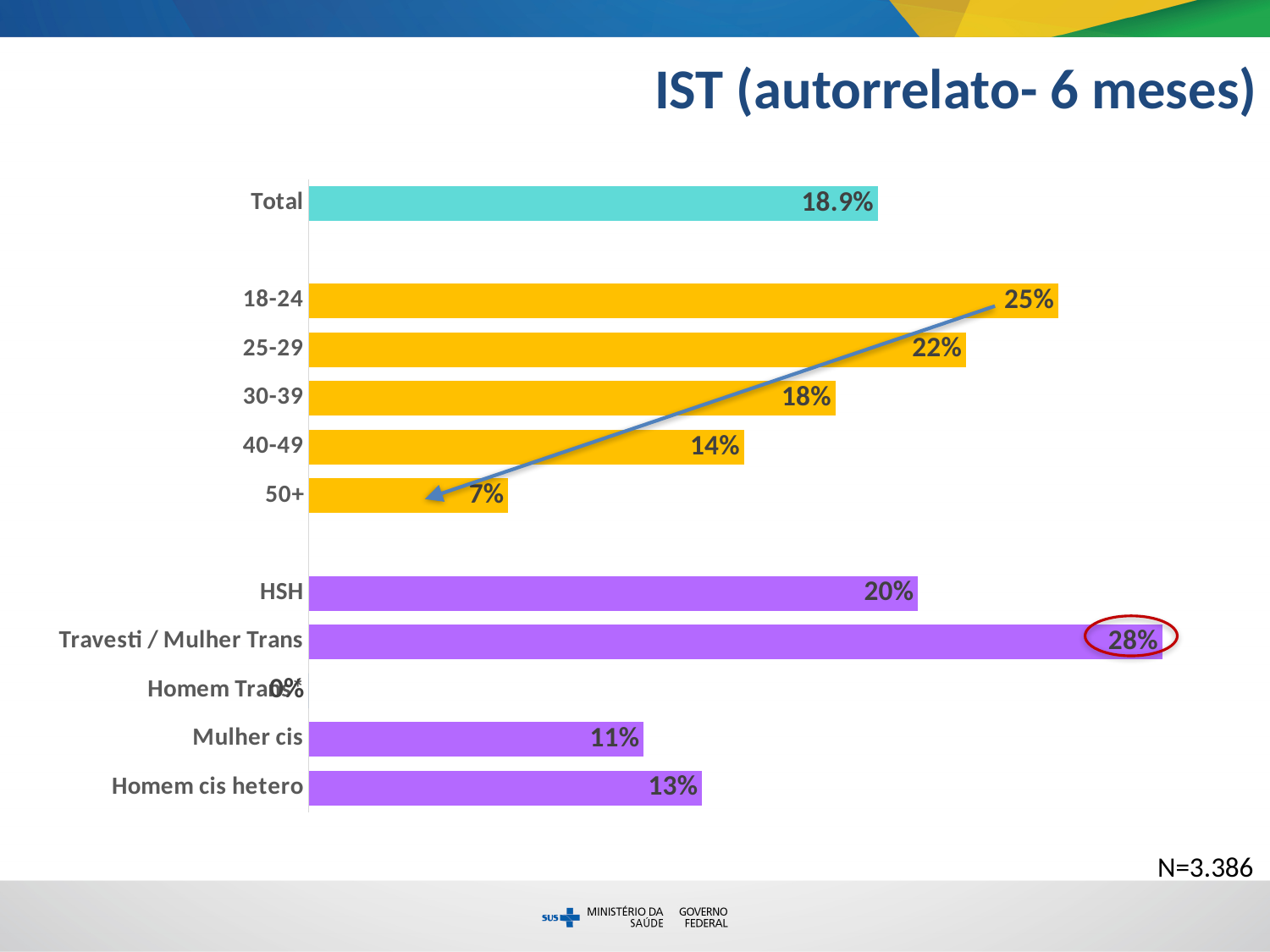
What is the value for Total? 18.9% What is the title of the chart? IST (autorrelato- 6 meses) What is the difference between the values for 18-24 and 50+? 18% What is the value for Travesti / Mulher Trans? 28% How many categories are shown in the chart? 11 What is the value for Mulher cis? 11% What is the value for the 18-24 age group? 25% Which category has the highest value? Travesti / Mulher Trans Which is larger, the value for HSH or the value for Homem cis hetero? HSH What kind of chart is shown on the slide? Bar chart Do the values fall or rise as the age groups go from 18-24 to 50+? Fall Among the age groups, which has the lowest value? 50+